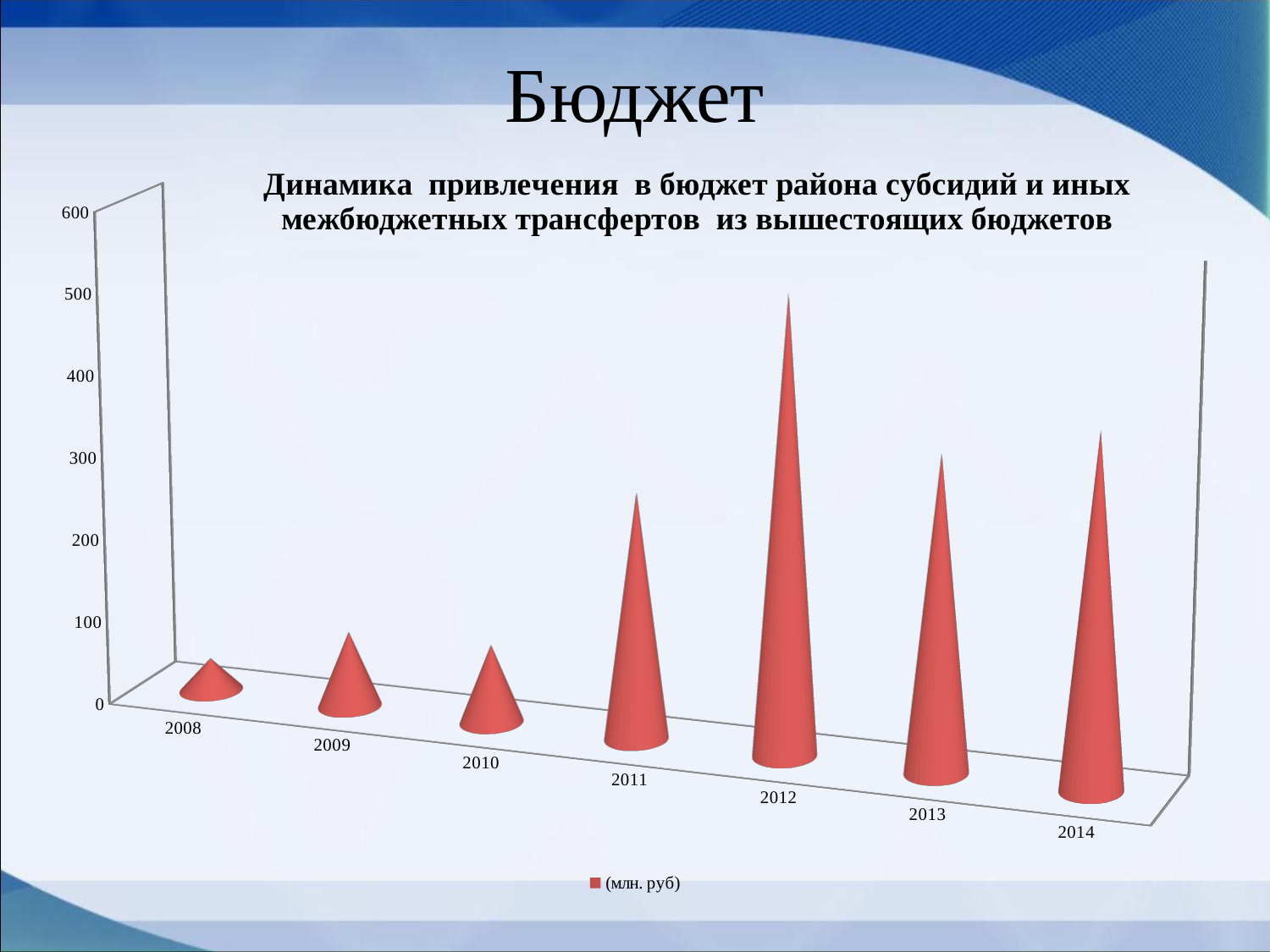
Which year has the highest value in the chart? 2012 Is the value for 2008 greater or less than 100? less What unit does the chart legend give for the series? (млн. руб) Which year has the larger value, 2011 or 2012? 2012 What kind of chart is shown on the slide? bar chart Which year has the larger value, 2008 or 2011? 2011 Is the value for 2012 greater or less than 400? greater How many series does the chart legend list? 1 Which year has the lowest value in the chart? 2008 How many years are shown on the x axis of the chart? 7 Is the value for 2013 greater or less than 200? greater Do the values generally rise or fall from 2008 to 2012? rise